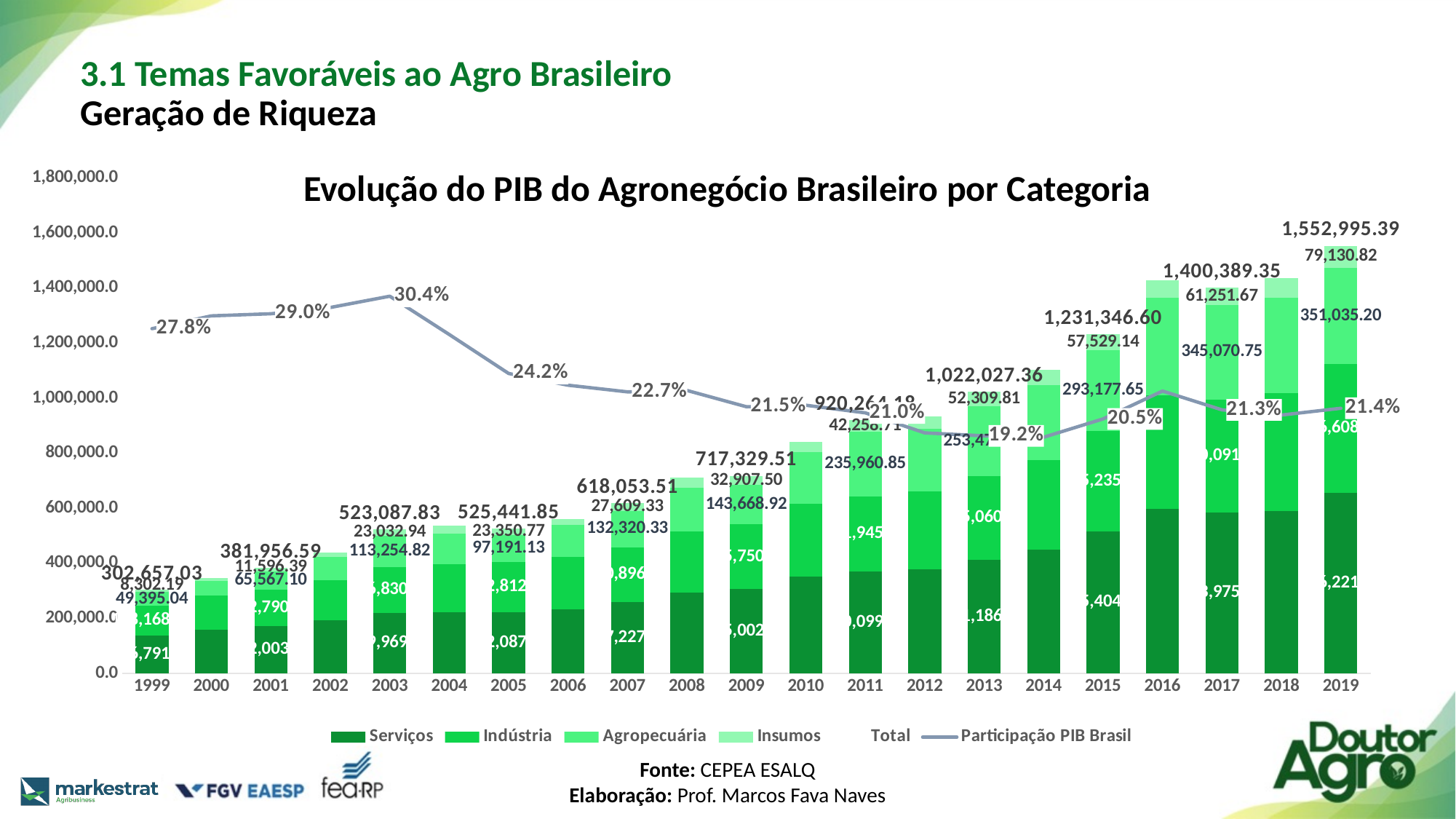
By how many percentage points does the Participação PIB Brasil value for 2003 exceed the value for 2019? 9.0 percentage points What kind of chart is shown on the slide? bar chart with a line How many years are shown on the x axis? 21 In which year is the Participação PIB Brasil line at its lowest labelled value? 2013 How many entries does the legend list? 6 What is the Insumos value for 2019? 79,130.82 Is the total bar for 2017 greater or less than 1,200,000.0? greater What is the Total value for 2019? 1,552,995.39 In which year is the Participação PIB Brasil line at its highest labelled value? 2003 Which year has the larger Total, 2014 or 2016? 2016 What is the Participação PIB Brasil value for 2003? 30.4%